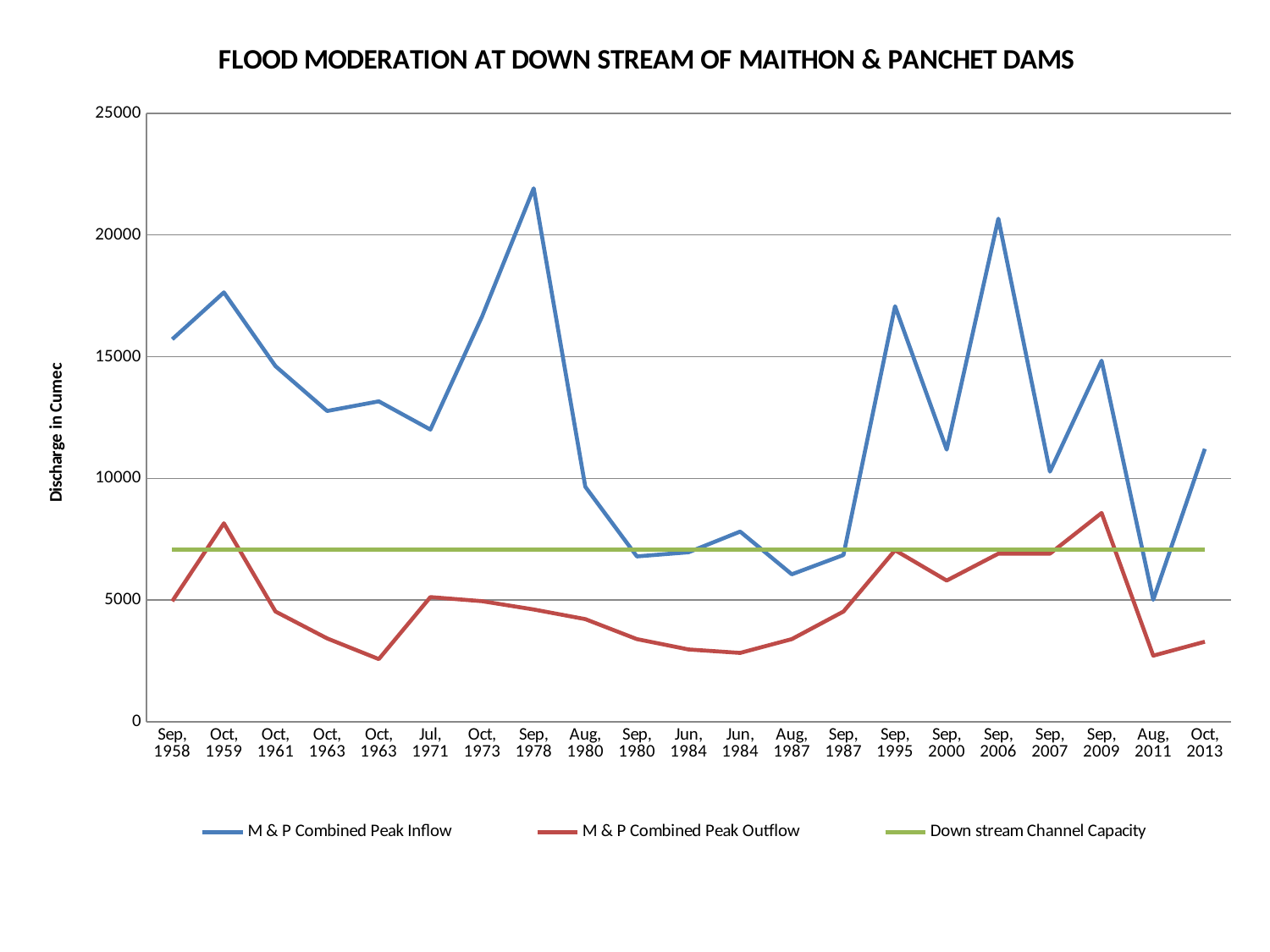
Does the M & P Combined Peak Outflow rise or fall from Jul, 1971 to Jun, 1984? Fall Is the M & P Combined Peak Outflow for Oct, 1959 greater or less than 5000? greater Which series is drawn in green? Down stream Channel Capacity At which date is the M & P Combined Peak Inflow highest? Sep, 1978 How many dated points are shown along the x axis? 21 Is the M & P Combined Peak Inflow for Sep, 1978 greater or less than 20000? greater What kind of chart is shown on the slide? Line chart At which date is the M & P Combined Peak Inflow lowest? Aug, 2011 How many series does the legend list? 3 Is the M & P Combined Peak Inflow for Sep, 1995 greater or less than 15000? greater Which is larger, the M & P Combined Peak Inflow for Sep, 1978 or for Sep, 1995? Sep, 1978